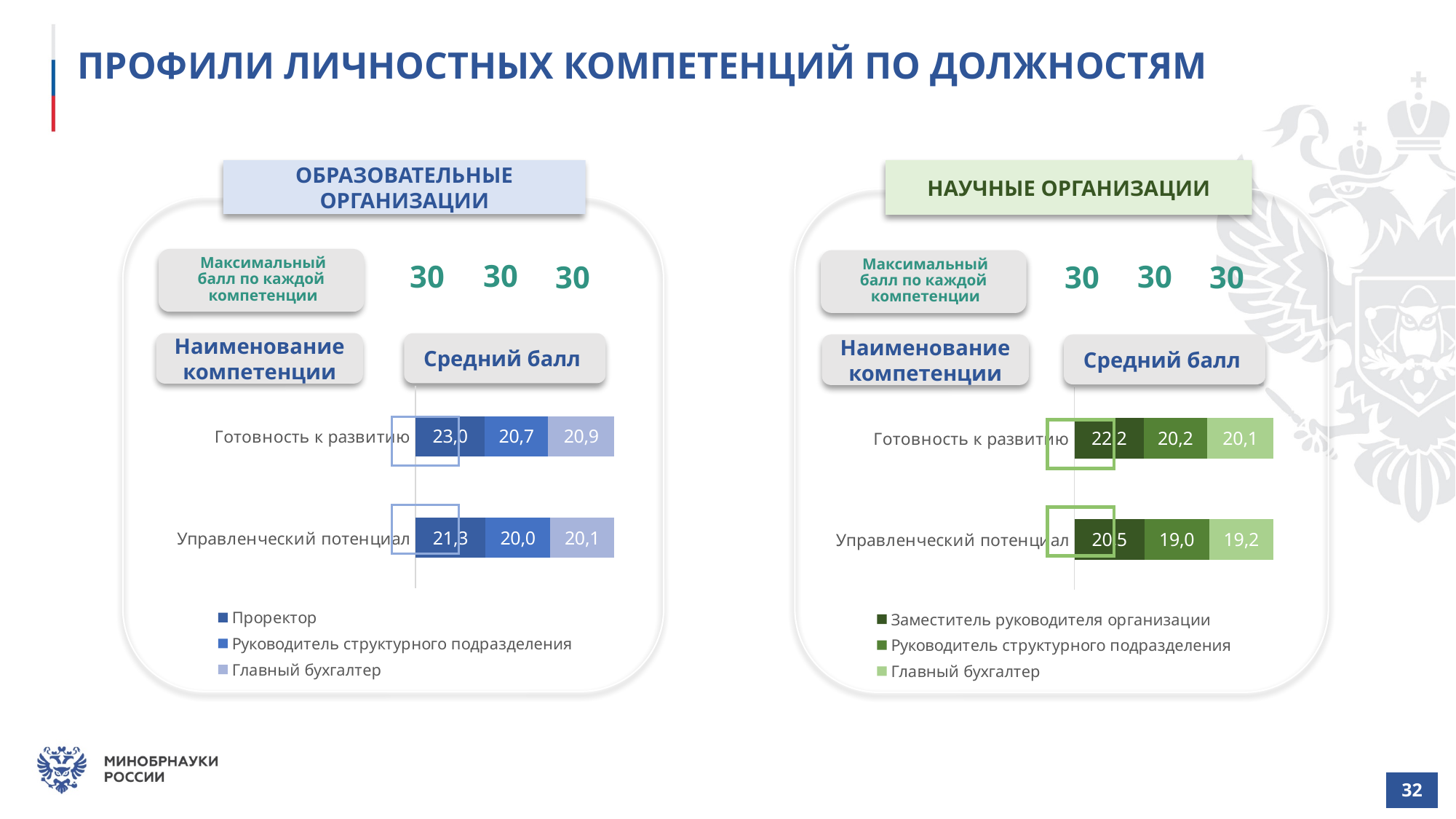
In the ОБРАЗОВАТЕЛЬНЫЕ ОРГАНИЗАЦИИ chart, what is the value for Руководитель структурного подразделения on Готовность к развитию? 20,7 In the НАУЧНЫЕ ОРГАНИЗАЦИИ chart, what is the value for Главный бухгалтер on Готовность к развитию? 20,1 What kind of chart is the ОБРАЗОВАТЕЛЬНЫЕ ОРГАНИЗАЦИИ chart? Stacked bar chart In the НАУЧНЫЕ ОРГАНИЗАЦИИ chart, which is larger for Главный бухгалтер: Готовность к развитию or Управленческий потенциал? Готовность к развитию In the НАУЧНЫЕ ОРГАНИЗАЦИИ chart, what is the value for Руководитель структурного подразделения on Управленческий потенциал? 19,0 In the ОБРАЗОВАТЕЛЬНЫЕ ОРГАНИЗАЦИИ chart, what is the value for Проректор on Готовность к развитию? 23,0 In the ОБРАЗОВАТЕЛЬНЫЕ ОРГАНИЗАЦИИ chart, what is the difference between the Проректор values for Готовность к развитию and Управленческий потенциал? 1,7 How many series does the legend of the НАУЧНЫЕ ОРГАНИЗАЦИИ chart list? 3 In the ОБРАЗОВАТЕЛЬНЫЕ ОРГАНИЗАЦИИ chart, which series has the highest value for Готовность к развитию? Проректор How many competency categories are shown in the ОБРАЗОВАТЕЛЬНЫЕ ОРГАНИЗАЦИИ chart? 2 In the НАУЧНЫЕ ОРГАНИЗАЦИИ chart, which series has the lowest value for Управленческий потенциал? Руководитель структурного подразделения In the ОБРАЗОВАТЕЛЬНЫЕ ОРГАНИЗАЦИИ chart, what is the value for Главный бухгалтер on Управленческий потенциал? 20,1